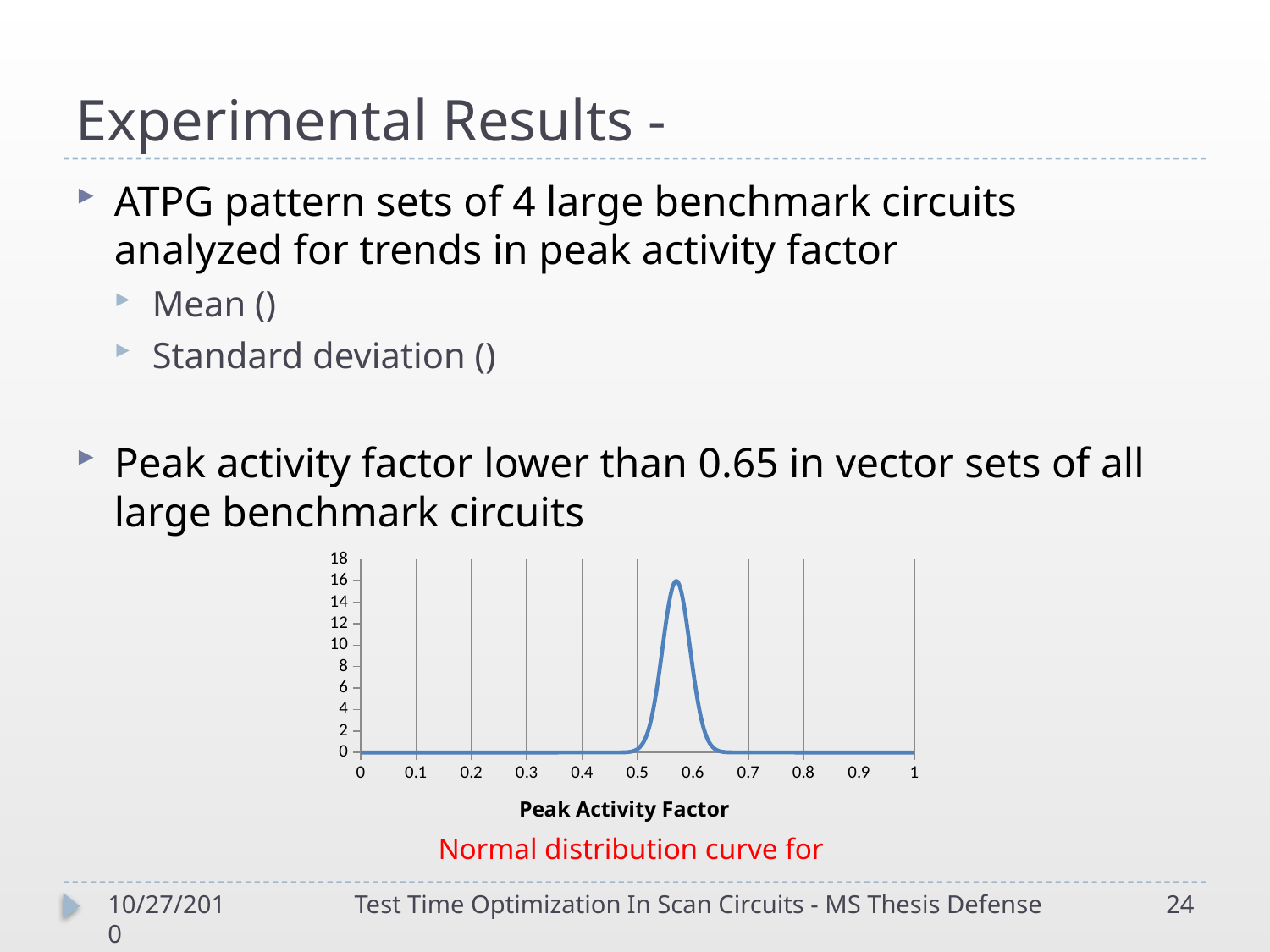
Does the curve rise or fall between a peak activity factor of 0.6 and 0.7? fall Is the value of the curve at a peak activity factor of 0.7 greater or less than the value at the peak? less Is the peak value of the curve greater or less than 18? less Is the peak value of the curve greater or less than 14? greater Does the curve rise or fall between a peak activity factor of 0.5 and the peak? rise What kind of chart is shown on the slide? line chart How many labelled tick marks are on the x axis of the chart? 11 Is the value of the curve at a peak activity factor of 0.9 greater or less than 2? less What is the highest value shown on the y axis of the chart? 18 Between which two labelled x-axis ticks does the peak of the curve occur? 0.5 and 0.6 What is the title of the x axis of the chart? Peak Activity Factor